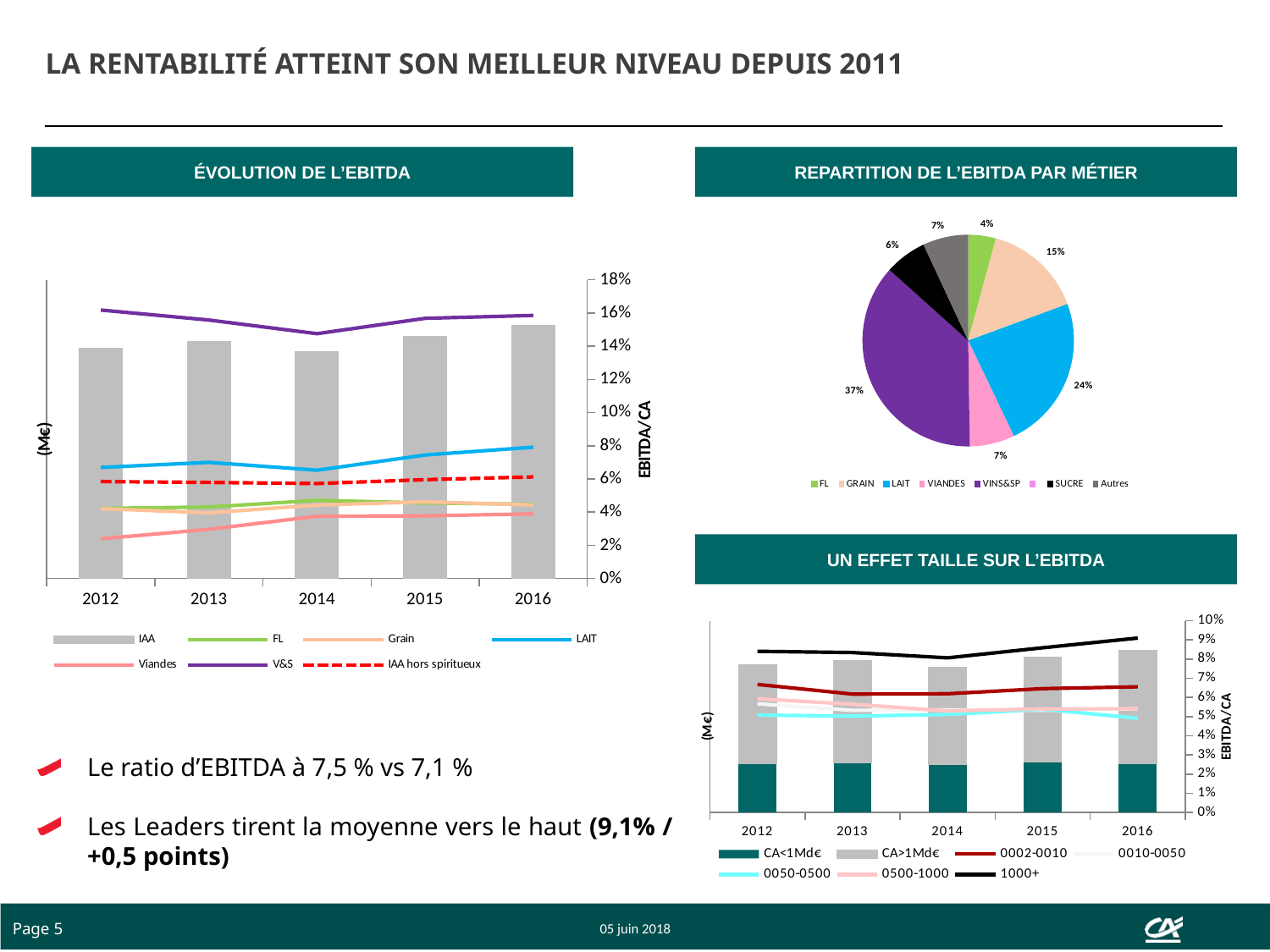
In the 'ÉVOLUTION DE L'EBITDA' chart, how many series does the legend list? 7 In the 'REPARTITION DE L'EBITDA PAR MÉTIER' pie chart, how many percentage points larger is the VINS&SP share than the LAIT share? 13 points In the 'ÉVOLUTION DE L'EBITDA' chart, how many years are shown on the x axis? 5 What kind of chart is 'REPARTITION DE L'EBITDA PAR MÉTIER'? Pie chart In the 'ÉVOLUTION DE L'EBITDA' chart, does the Viandes line rise or fall from 2012 to 2016? rise In the 'UN EFFET TAILLE SUR L'EBITDA' chart, is the 1000+ value for 2016 greater or less than 8%? greater In the 'REPARTITION DE L'EBITDA PAR MÉTIER' pie chart, what share does LAIT have? 24% In the 'REPARTITION DE L'EBITDA PAR MÉTIER' pie chart, which métier has the largest share? VINS&SP In the 'REPARTITION DE L'EBITDA PAR MÉTIER' pie chart, which métier has the smallest share? FL In the 'ÉVOLUTION DE L'EBITDA' chart, is the V&S value for 2012 greater or less than 14%? greater In the 'REPARTITION DE L'EBITDA PAR MÉTIER' pie chart, what share does VINS&SP have? 37% In the 'REPARTITION DE L'EBITDA PAR MÉTIER' pie chart, which is larger, the GRAIN share or the LAIT share? LAIT